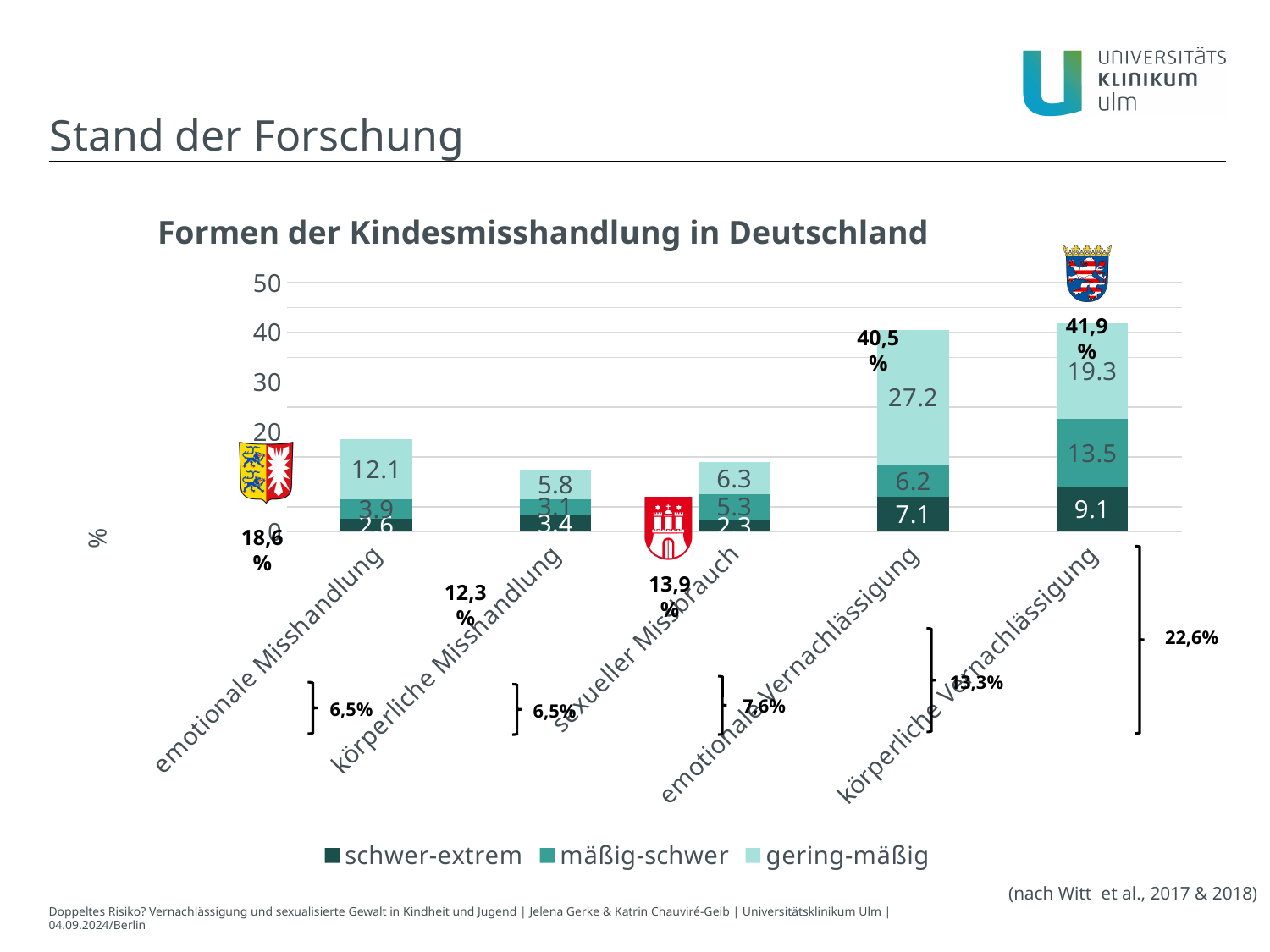
What is the gering-mäßig value for emotionale Misshandlung? 12.1 What is the gering-mäßig value for emotionale Vernachlässigung? 27.2 What is the schwer-extrem value for körperliche Vernachlässigung? 9.1 How many categories are shown on the x axis? 5 How many series does the legend list? 3 Which category has the highest schwer-extrem value? körperliche Vernachlässigung Which category has the lowest gering-mäßig value? körperliche Misshandlung What kind of chart is shown on the slide? stacked bar chart What is the difference between the mäßig-schwer values for körperliche Vernachlässigung and emotionale Vernachlässigung? 7.3 What is the total of the stacked bar for körperliche Vernachlässigung as labelled on the slide? 41,9 % What is the mäßig-schwer value for sexueller Missbrauch? 5.3 Which is larger: the gering-mäßig value for sexueller Missbrauch or for körperliche Misshandlung? sexueller Missbrauch